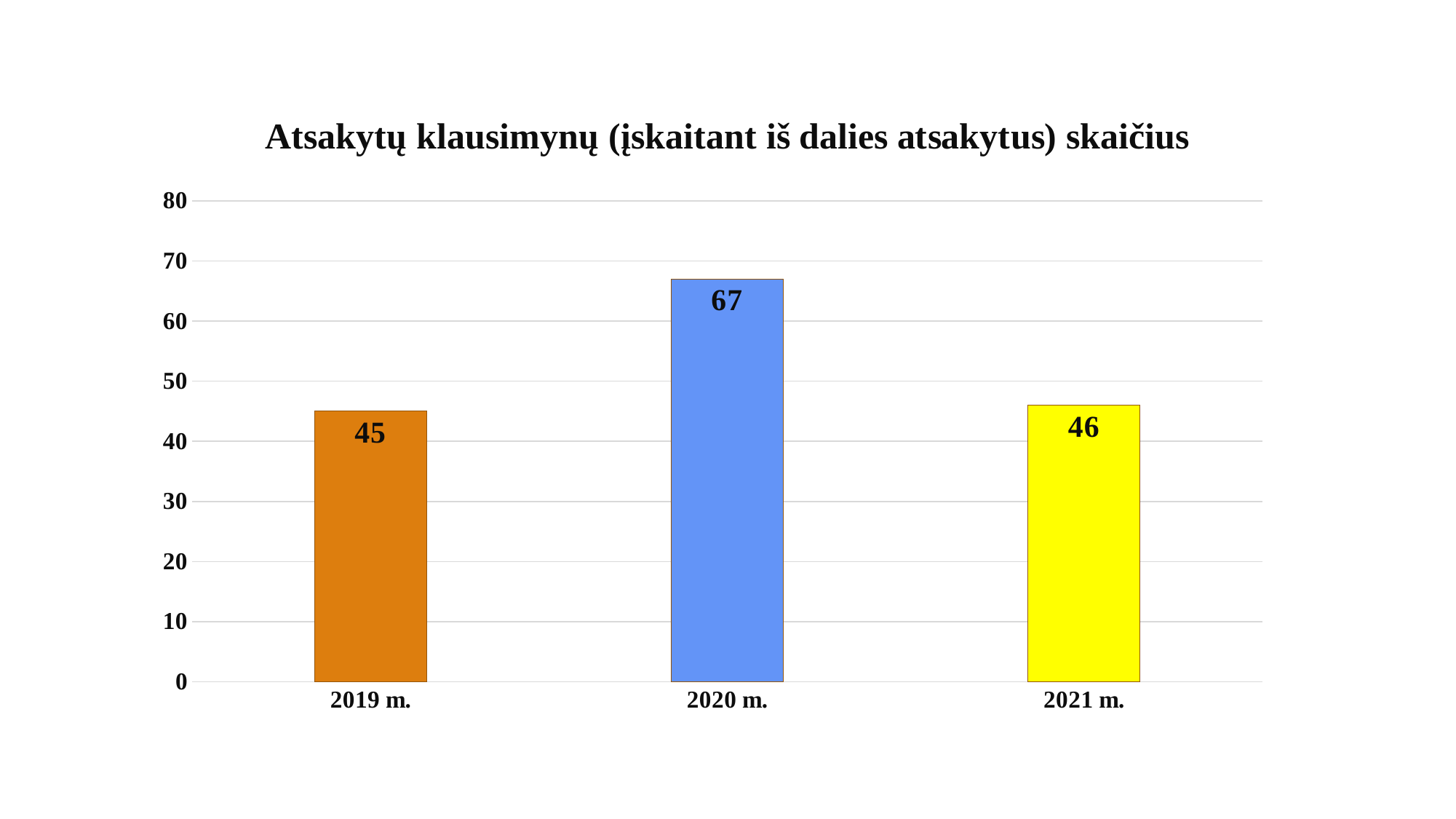
What is the value for 2021 m.? 46 What is the difference between the values for 2020 m. and 2019 m.? 22 How many years are shown on the chart? 3 What is the value for 2020 m.? 67 Which is larger, the value for 2020 m. or the value for 2021 m.? 2020 m. Is the value for 2020 m. greater or less than 60? greater What is the difference between the values for 2020 m. and 2021 m.? 21 What kind of chart is shown on the slide? Bar chart What is the value for 2019 m.? 45 Which year has the lowest value? 2019 m. What is the title of the chart? Atsakytų klausimynų (įskaitant iš dalies atsakytus) skaičius Which year has the highest value? 2020 m.